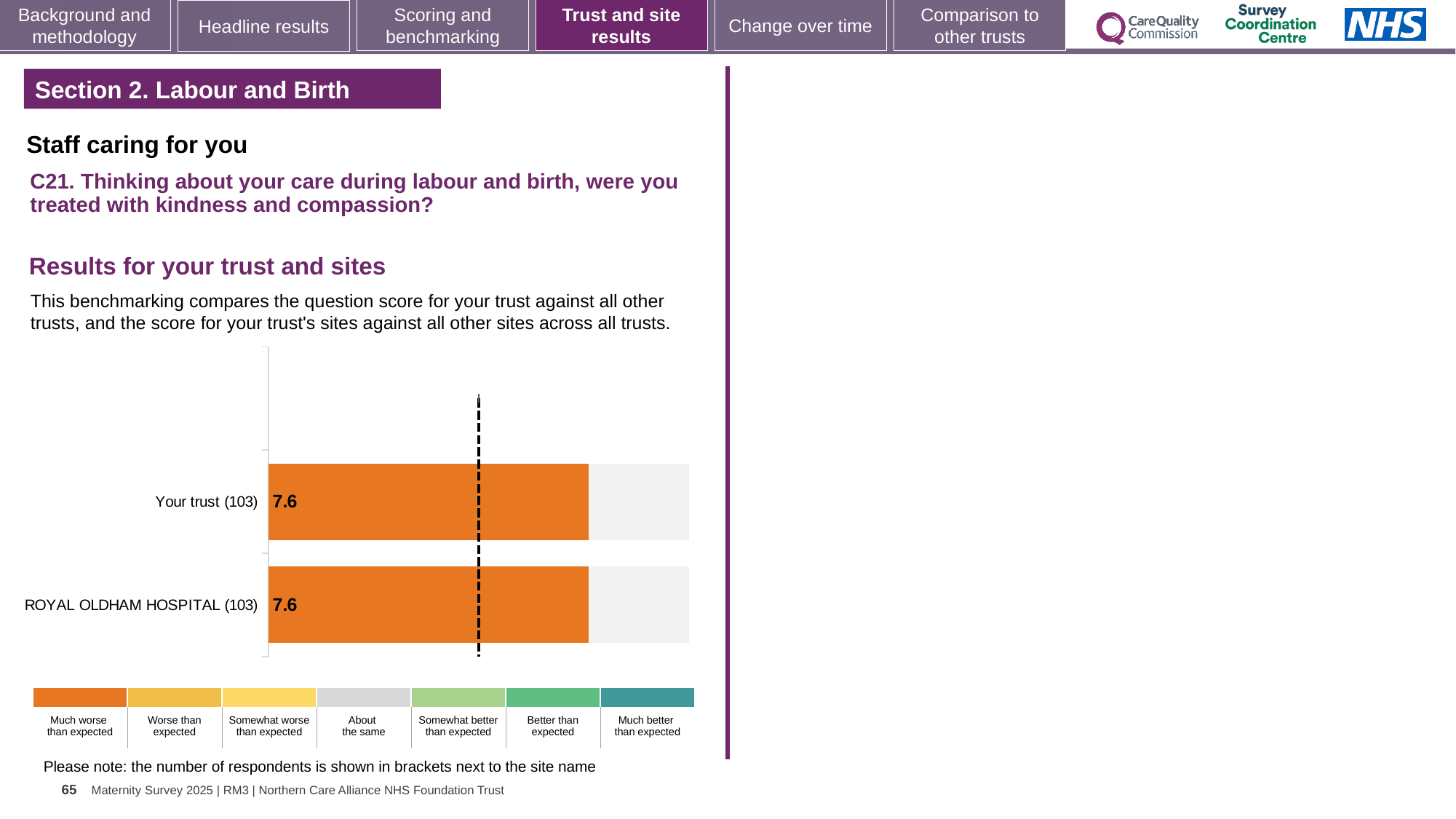
What is the score shown for Your trust (103)? 7.6 What kind of chart is used to show the results for your trust and sites? Bar chart Which benchmark category does the colour of the bar for Your trust (103) correspond to? Much worse than expected How many respondents are shown in brackets for ROYAL OLDHAM HOSPITAL? 103 What is the score shown for ROYAL OLDHAM HOSPITAL (103)? 7.6 How many bars are plotted in the chart? 2 How many benchmark categories does the colour key below the chart list? 7 What is the difference between the score for Your trust (103) and the score for ROYAL OLDHAM HOSPITAL (103)? 0 Do the two bars in the chart have the same score? Yes